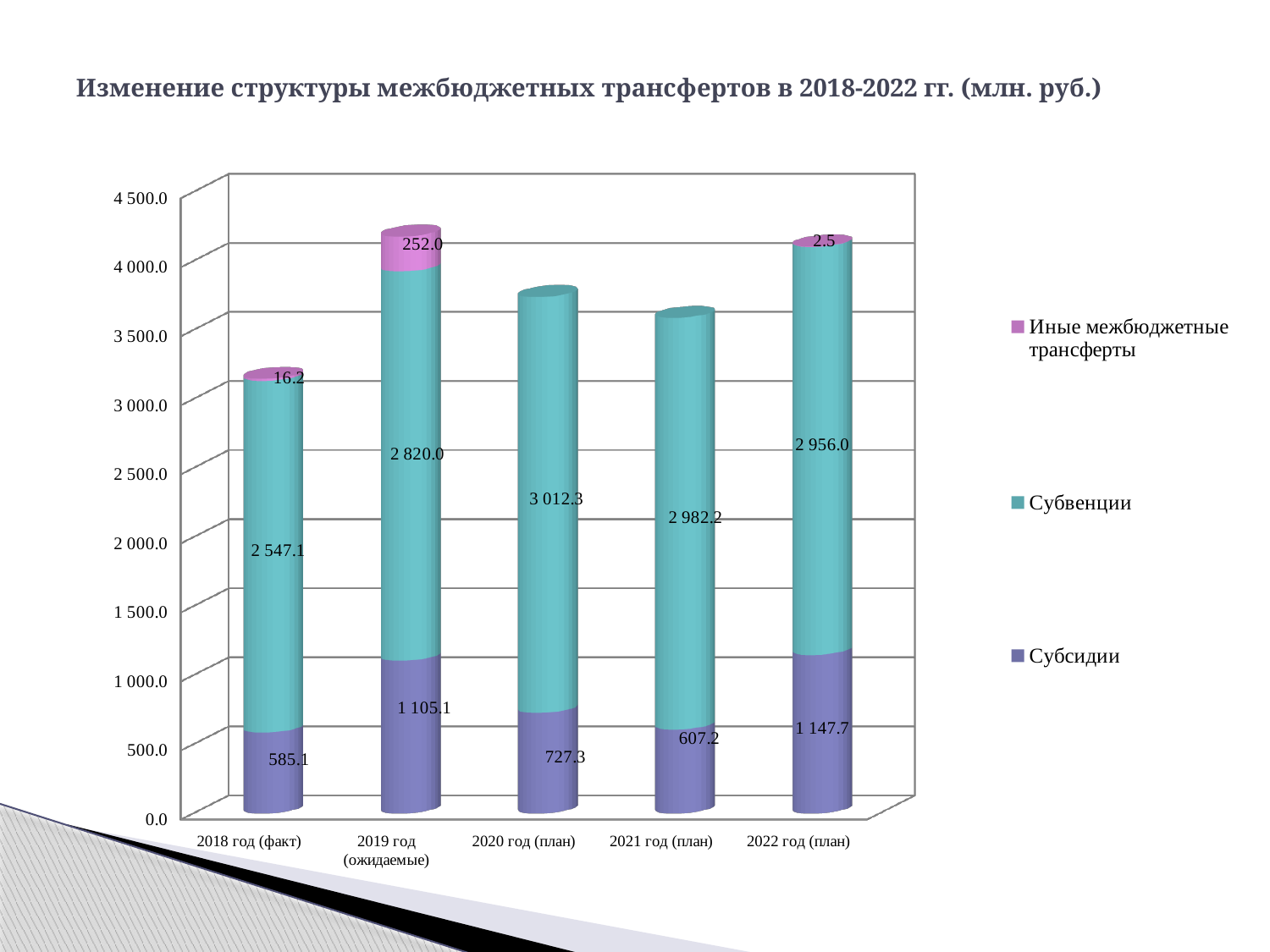
What is the value of Субсидии for 2019 год (ожидаемые)? 1 105.1 What type of chart is shown on the slide? Stacked bar chart What is the difference between the Субвенции values for 2020 год (план) and 2018 год (факт)? 465.2 How many year categories are shown on the x axis? 5 In which year is the Субсидии value the highest? 2022 год (план) What is the value of Иные межбюджетные трансферты for 2022 год (план)? 2.5 What is the title of the chart? Изменение структуры межбюджетных трансфертов в 2018-2022 гг. (млн. руб.) In which year is the Субвенции value the lowest? 2018 год (факт) What is the value of Субвенции for 2020 год (план)? 3 012.3 What is the total of the stacked bar for 2019 год (ожидаемые)? 4 177.1 How many series does the legend list? 3 Which is larger: Субсидии for 2020 год (план) or Субсидии for 2021 год (план)? 2020 год (план)